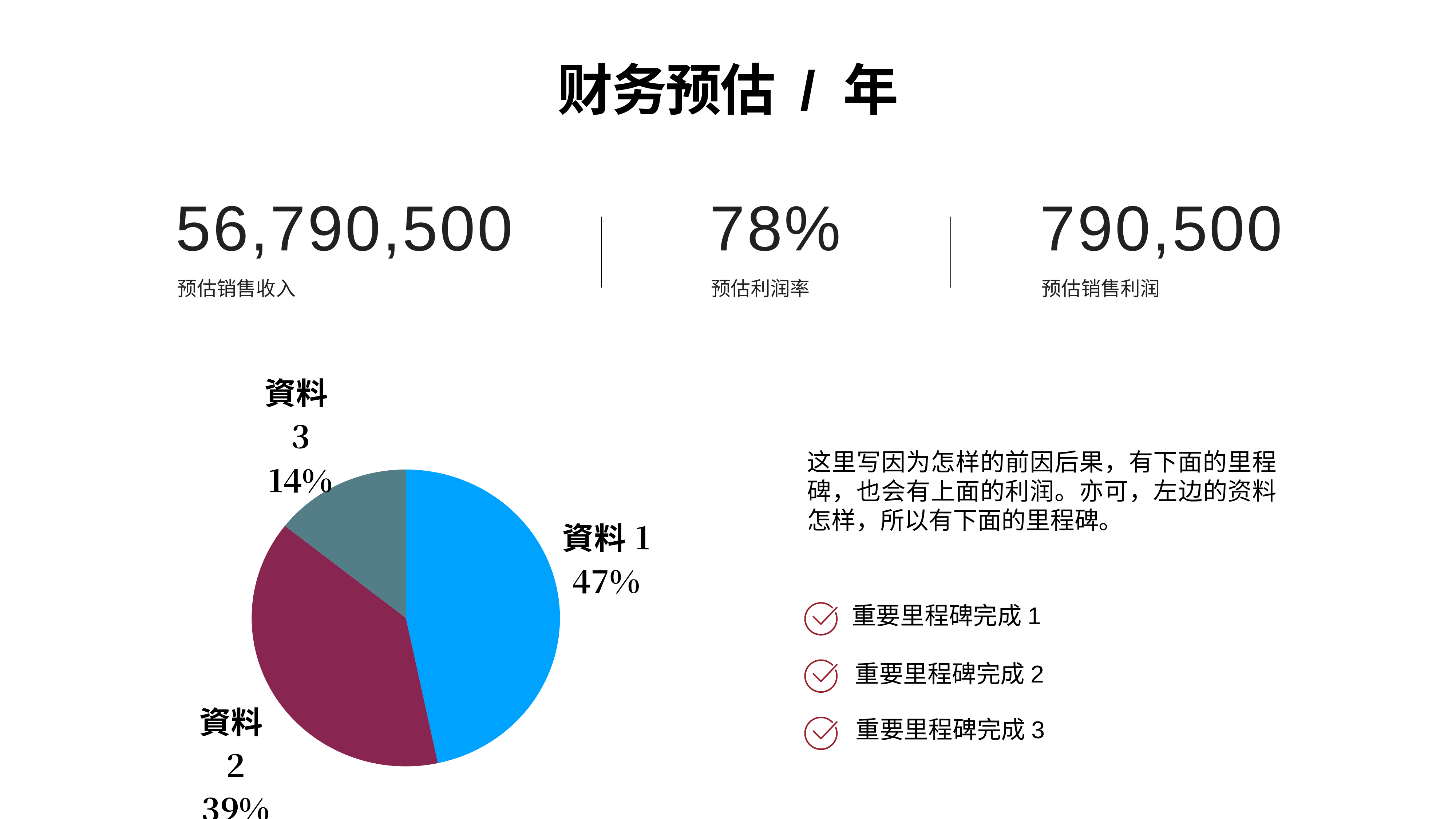
What is the difference in percentage points between the shares of 資料 1 and 資料 2? 8 What share of the pie does 資料 3 represent? 14% Which is larger, the share for 資料 2 or the share for 資料 3? 資料 2 What is the difference in percentage points between the shares of 資料 2 and 資料 3? 25 How many slices does the pie chart have? 3 What share of the pie does 資料 2 represent? 39% Which slice of the pie chart is the smallest? 資料 3 What colour is the slice for 資料 3 in the pie chart? grey Which slice of the pie chart is the largest? 資料 1 What colour is the slice for 資料 1 in the pie chart? blue What share of the pie does 資料 1 represent? 47% What kind of chart is shown on the slide? pie chart